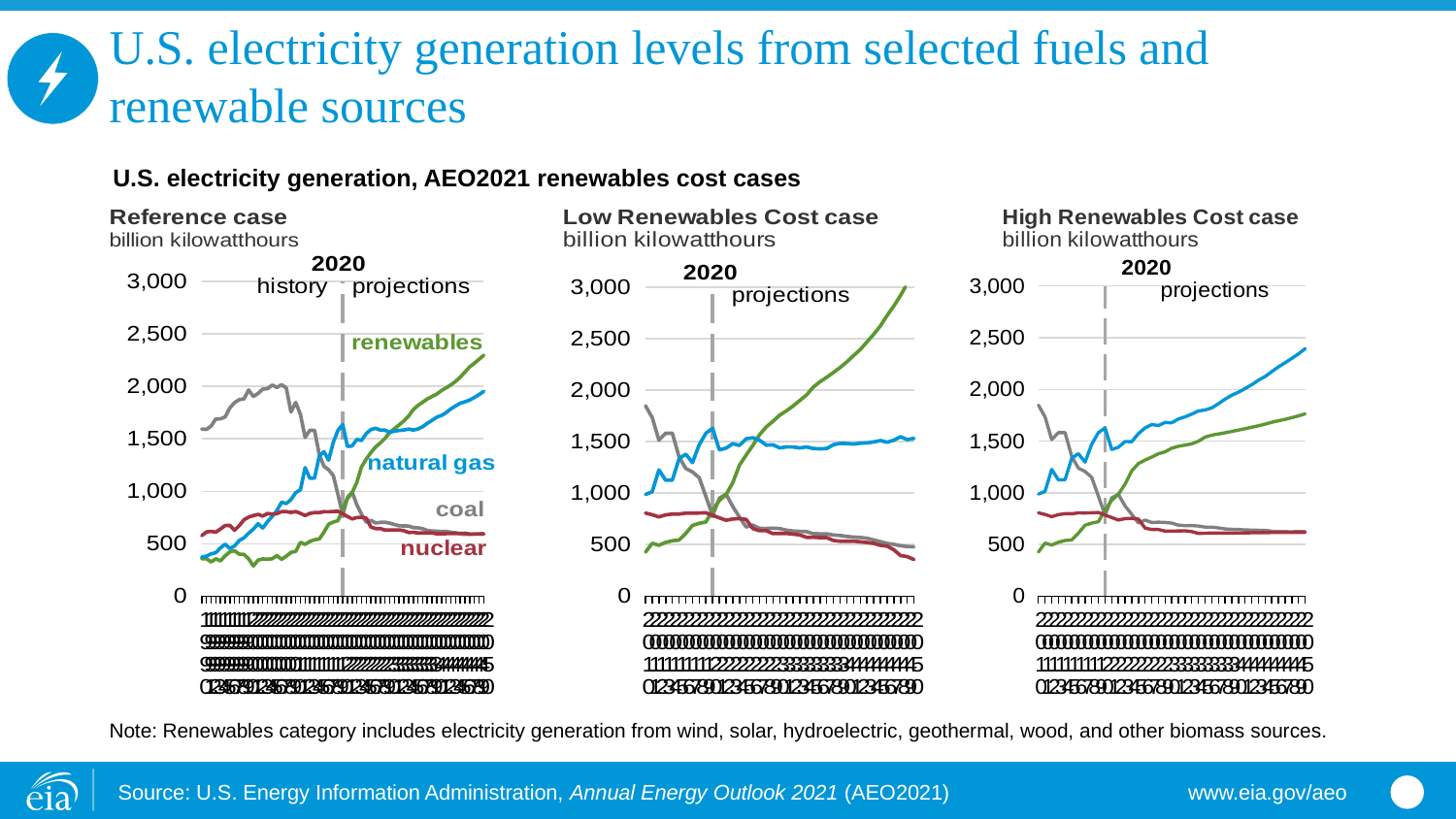
In the Low Renewables Cost case chart, which series is highest at the end of the projection period? renewables In the Low Renewables Cost case chart, is the value for renewables at the end of the projection period greater or less than 2,500? greater In the Reference case chart, is the value for renewables at the end of the projection period greater or less than 2,000? greater In the Low Renewables Cost case chart, which series is lowest at the end of the projection period? nuclear In the Reference case chart, is the value for coal at the end of the projection period greater or less than 1,000? less How many fuel series are labeled on the Reference case chart? 4 How many charts are shown on the slide? 3 In the High Renewables Cost case chart, which is higher at the end of the projection period, natural gas or renewables? natural gas What kind of chart is used for the Reference case? line chart In the Reference case chart, does coal rise or fall over the projection period? fall What unit is used on the y axis of the three charts? billion kilowatthours